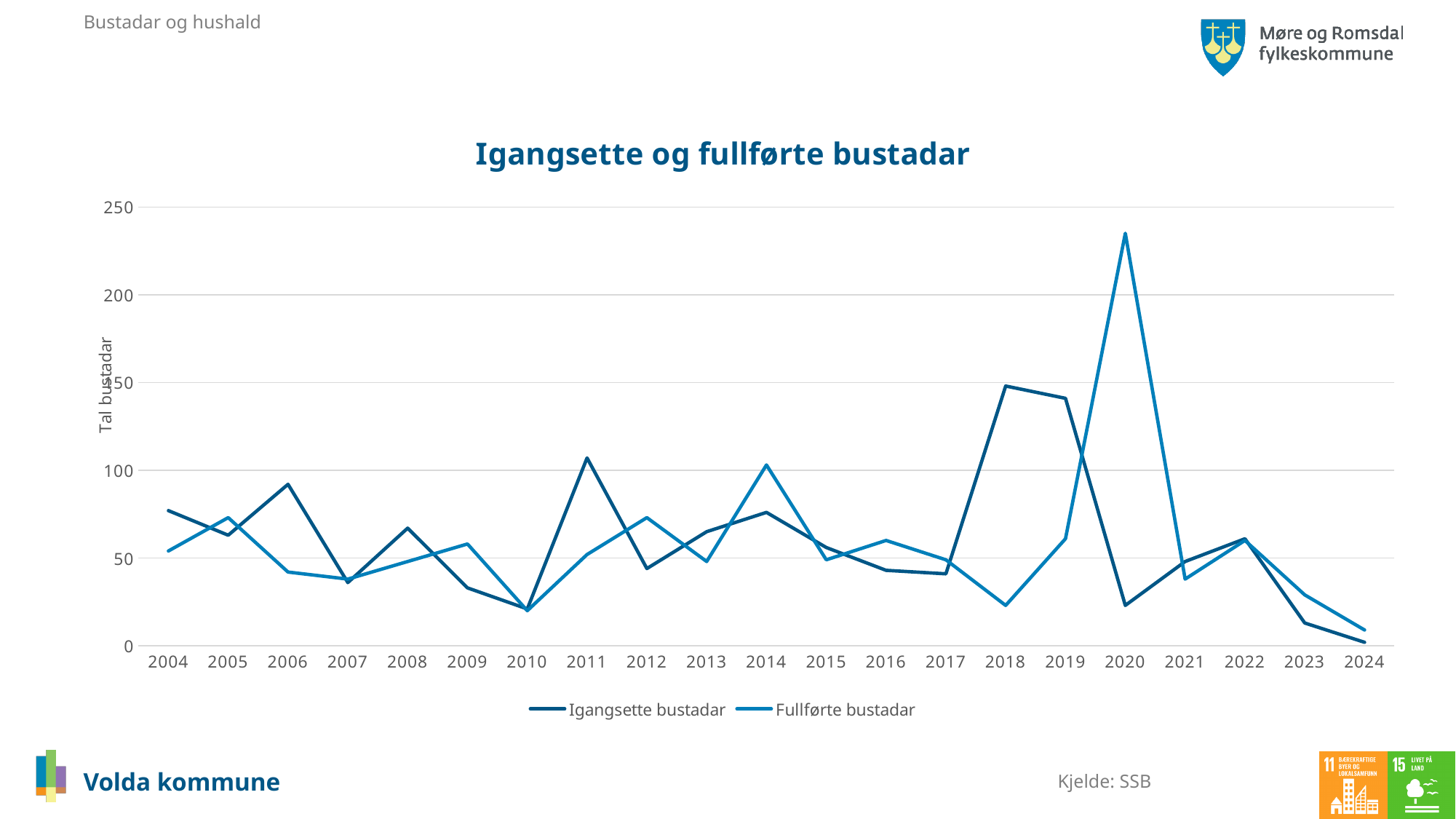
How many years are shown on the x axis? 21 In 2018, which series has the larger value, Igangsette bustadar or Fullførte bustadar? Igangsette bustadar What kind of chart is shown on the slide? line chart How many series does the legend list? 2 Is the value for Igangsette bustadar in 2018 greater or less than 100? greater In which year does the Igangsette bustadar series reach its highest value? 2018 In which year does the Fullførte bustadar series reach its highest value? 2020 What is the title of the chart? Igangsette og fullførte bustadar Do the values for Fullførte bustadar rise or fall from 2020 to 2024? fall Is the value for Igangsette bustadar in 2010 greater or less than 50? less In which year does the Igangsette bustadar series reach its lowest value? 2024 Is the value for Fullførte bustadar in 2020 greater or less than 200? greater